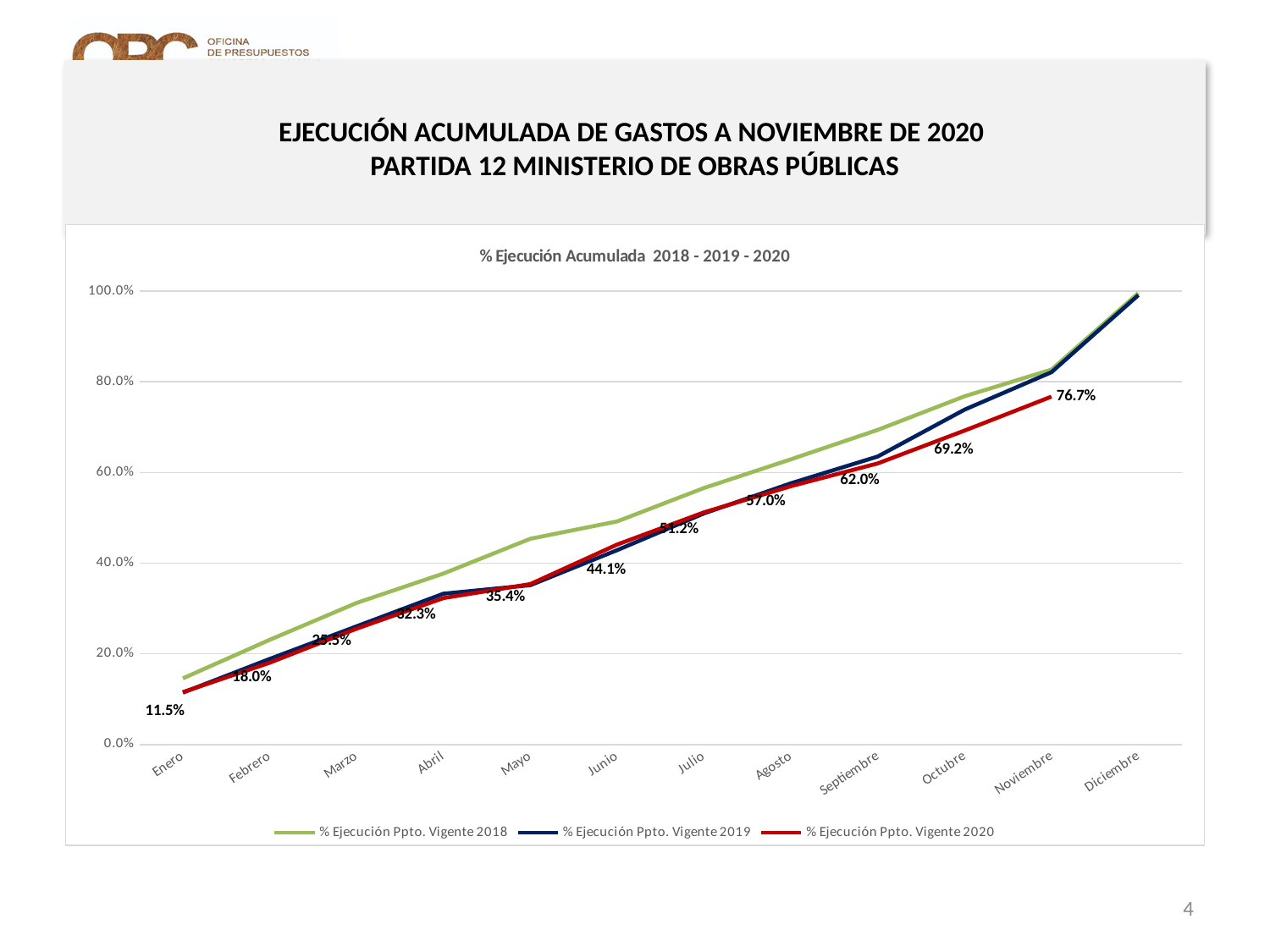
What is the value for % Ejecución Ppto. Vigente 2020 in Noviembre? 76.7% What is the value for % Ejecución Ppto. Vigente 2020 in Enero? 11.5% Do the values of the 2020 series rise or fall from Enero to Noviembre? rise What is the title of the chart? % Ejecución Acumulada 2018 - 2019 - 2020 What is the difference between the 2020 values for Noviembre and Octubre? 7.5% How many series does the chart legend list? 3 In Julio, which series has the larger value: 2018 or 2020? 2018 What is the difference between the 2020 values for Septiembre and Agosto? 5.0% How many months are shown on the x axis? 12 What is the value for % Ejecución Ppto. Vigente 2020 in Junio? 44.1% Is the value for % Ejecución Ppto. Vigente 2018 in Diciembre greater or less than 80.0%? greater What kind of chart is shown on the slide? line chart